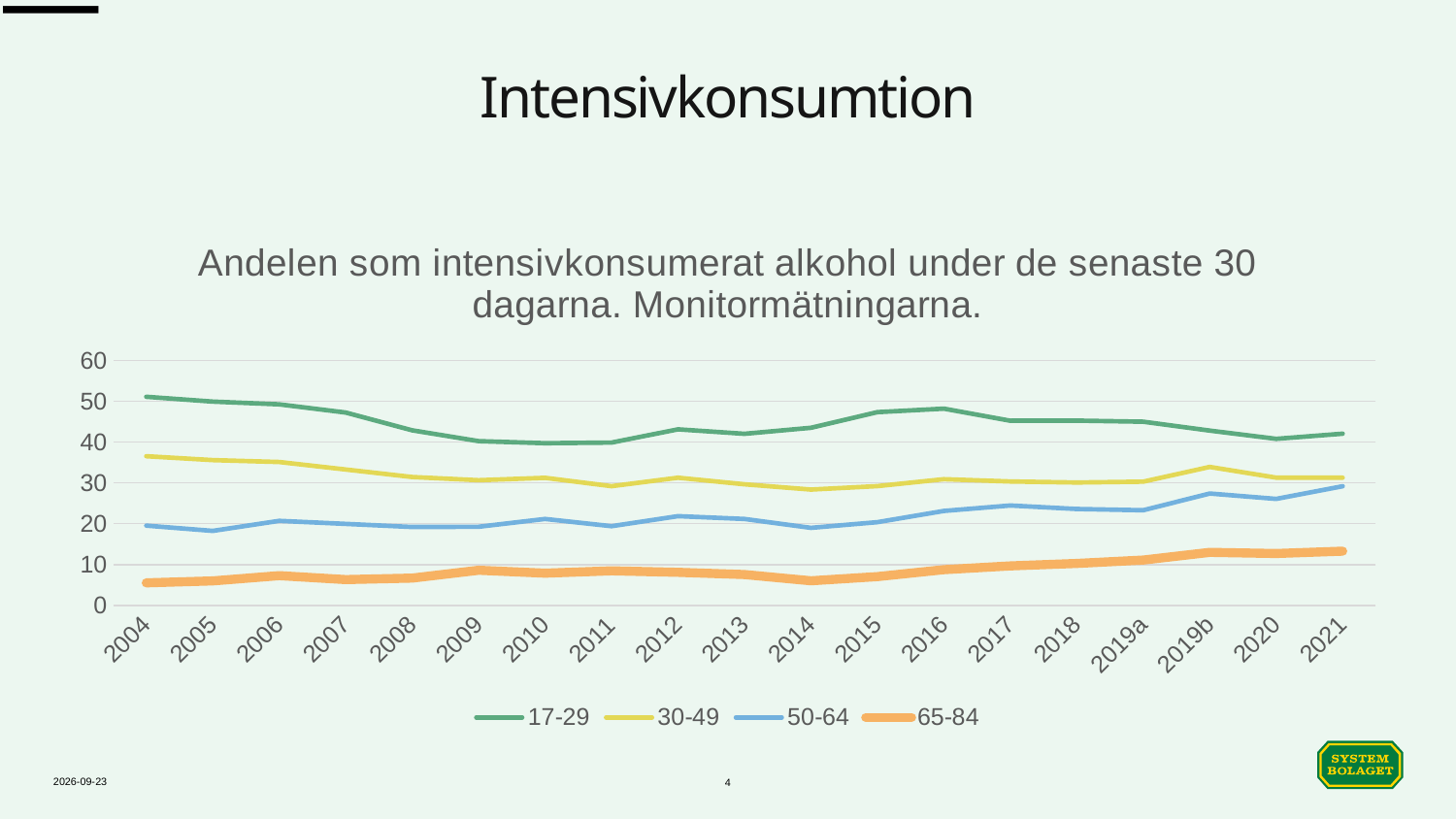
How many points are shown along the x axis? 19 Is the value for 50-64 in 2021 greater or less than 20? greater Which is larger in 2010, the value for 17-29 or the value for 30-49? 17-29 Which age group has the highest value in 2016? 17-29 Does the 65-84 line rise or fall overall from 2004 to 2021? rise Is the value for 17-29 in 2020 greater or less than 50? less What is the title of the chart? Andelen som intensivkonsumerat alkohol under de senaste 30 dagarna. Monitormätningarna. Which age group has the lowest value in 2021? 65-84 Is the value for 65-84 in 2004 greater or less than 10? less How many series does the legend list? 4 What kind of chart is shown on the slide? Line chart